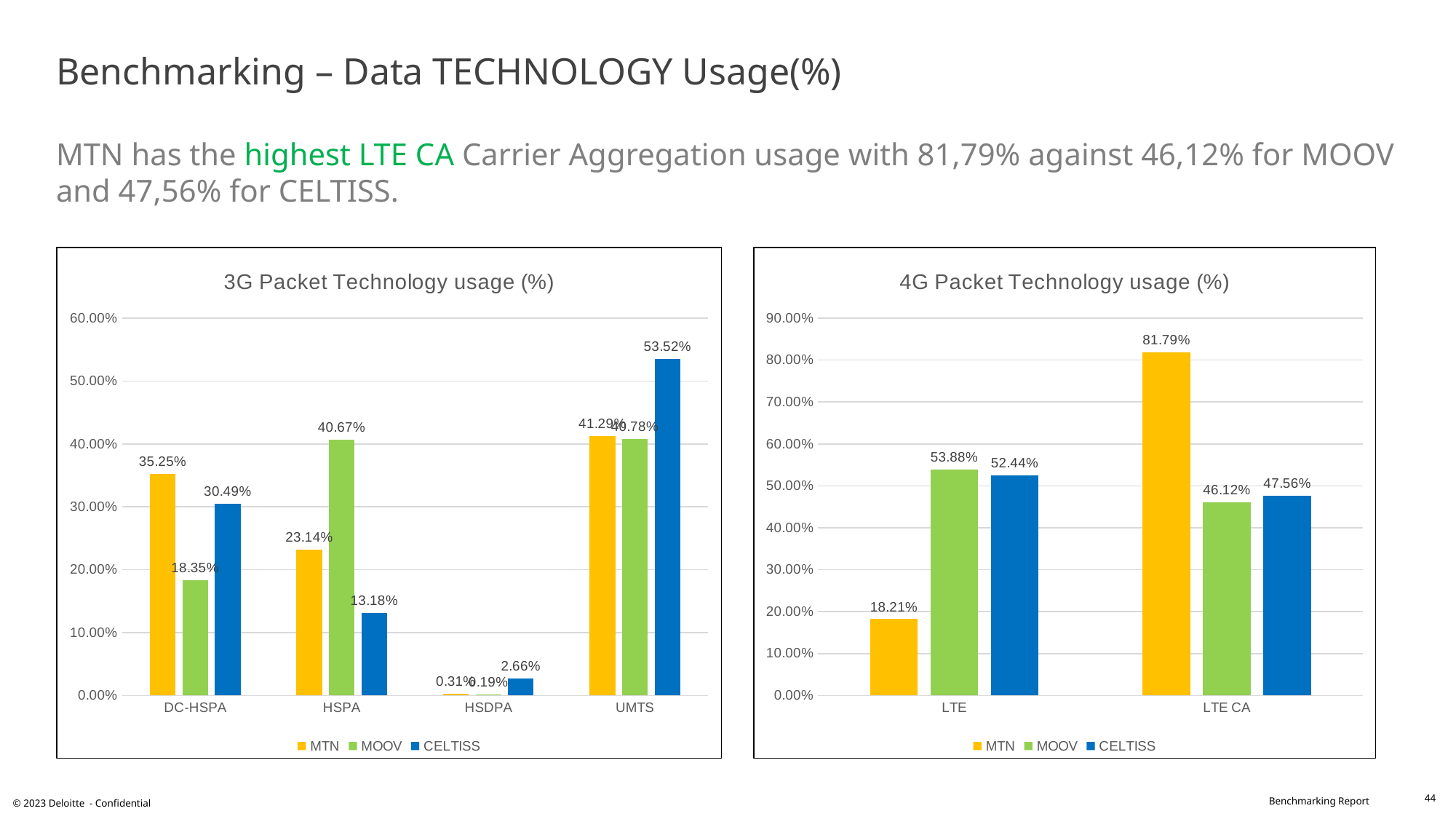
In the 4G Packet Technology usage (%) chart, what is the value for MTN in the LTE CA category? 81.79% In the 4G Packet Technology usage (%) chart, what is the difference between MTN and MOOV in the LTE CA category? 35.67% In the 4G Packet Technology usage (%) chart, is the value for MTN in the LTE category greater or less than 20.00%? less In the 4G Packet Technology usage (%) chart, which series has the highest value in the LTE category? MOOV In the 3G Packet Technology usage (%) chart, what is the value for CELTISS in the UMTS category? 53.52% In the 3G Packet Technology usage (%) chart, what is the value for MOOV in the HSPA category? 40.67% How many categories are shown on the x axis of the 3G Packet Technology usage (%) chart? 4 In the 3G Packet Technology usage (%) chart, which series has the lowest value in the HSDPA category? MOOV In the 3G Packet Technology usage (%) chart, which is larger for DC-HSPA: MTN or CELTISS? MTN What kind of chart is the 3G Packet Technology usage (%) chart? Bar chart In the 4G Packet Technology usage (%) chart, which colour represents CELTISS? Blue How many series does the legend of the 4G Packet Technology usage (%) chart list? 3